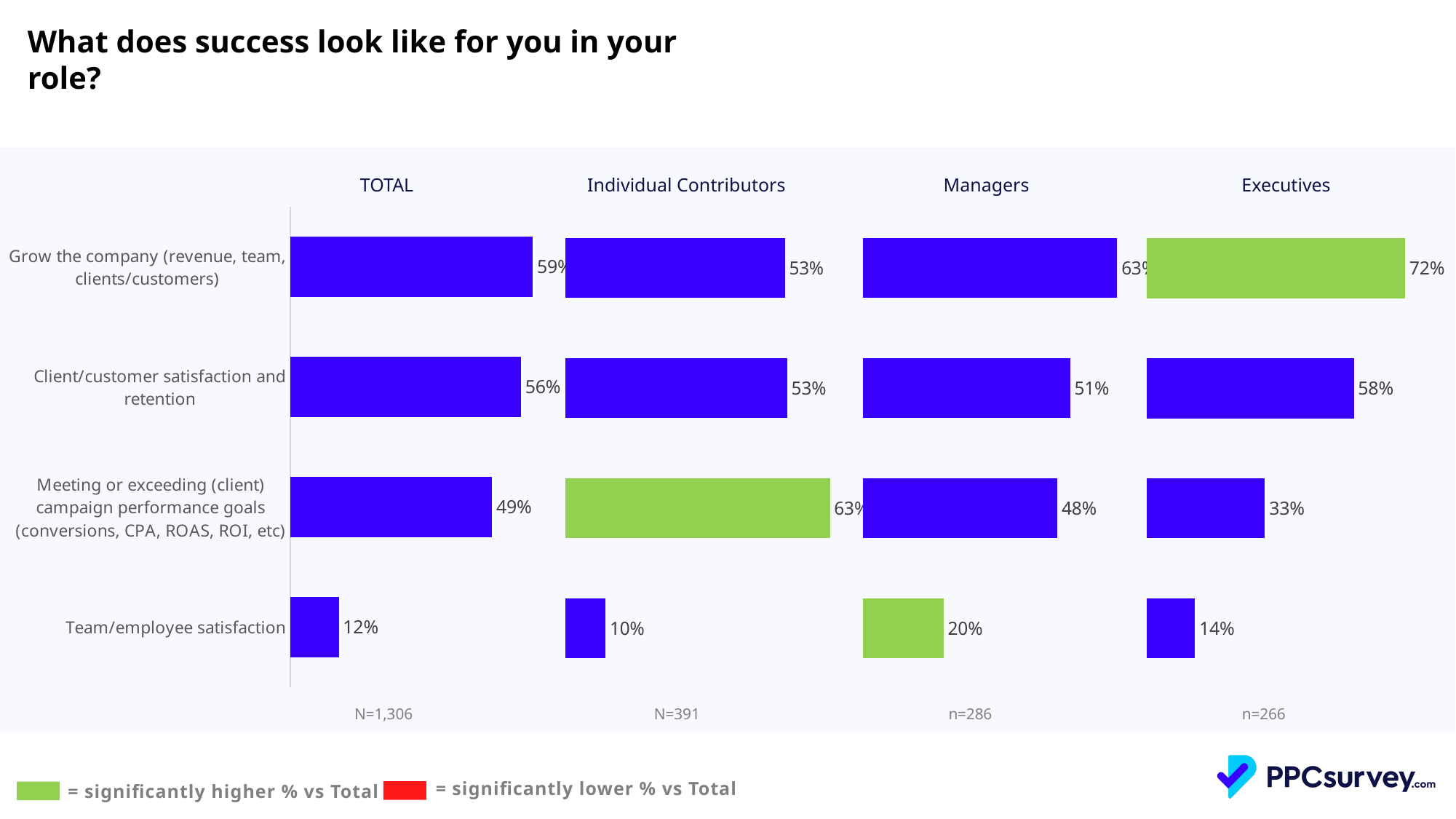
In the Executives chart, what percentage is shown for 'Grow the company (revenue, team, clients/customers)'? 72% In the Executives chart, which category has the lowest percentage? Team/employee satisfaction In the Individual Contributors chart, what percentage is shown for 'Meeting or exceeding (client) campaign performance goals'? 63% In the TOTAL chart, what percentage is shown for 'Grow the company (revenue, team, clients/customers)'? 59% What type of chart is used on this slide? Bar chart For 'Meeting or exceeding (client) campaign performance goals', which is larger: the Managers value or the Executives value? Managers According to the legend, what does a green bar indicate? Significantly higher % vs Total What is the sample size shown under the TOTAL chart? N=1,306 In the Individual Contributors chart, which category has the highest percentage? Meeting or exceeding (client) campaign performance goals In the Managers chart, what percentage is shown for 'Team/employee satisfaction'? 20% What is the difference between the Executives and Individual Contributors percentages for 'Grow the company (revenue, team, clients/customers)'? 19 percentage points How many categories are listed on the y axis of the charts? 4